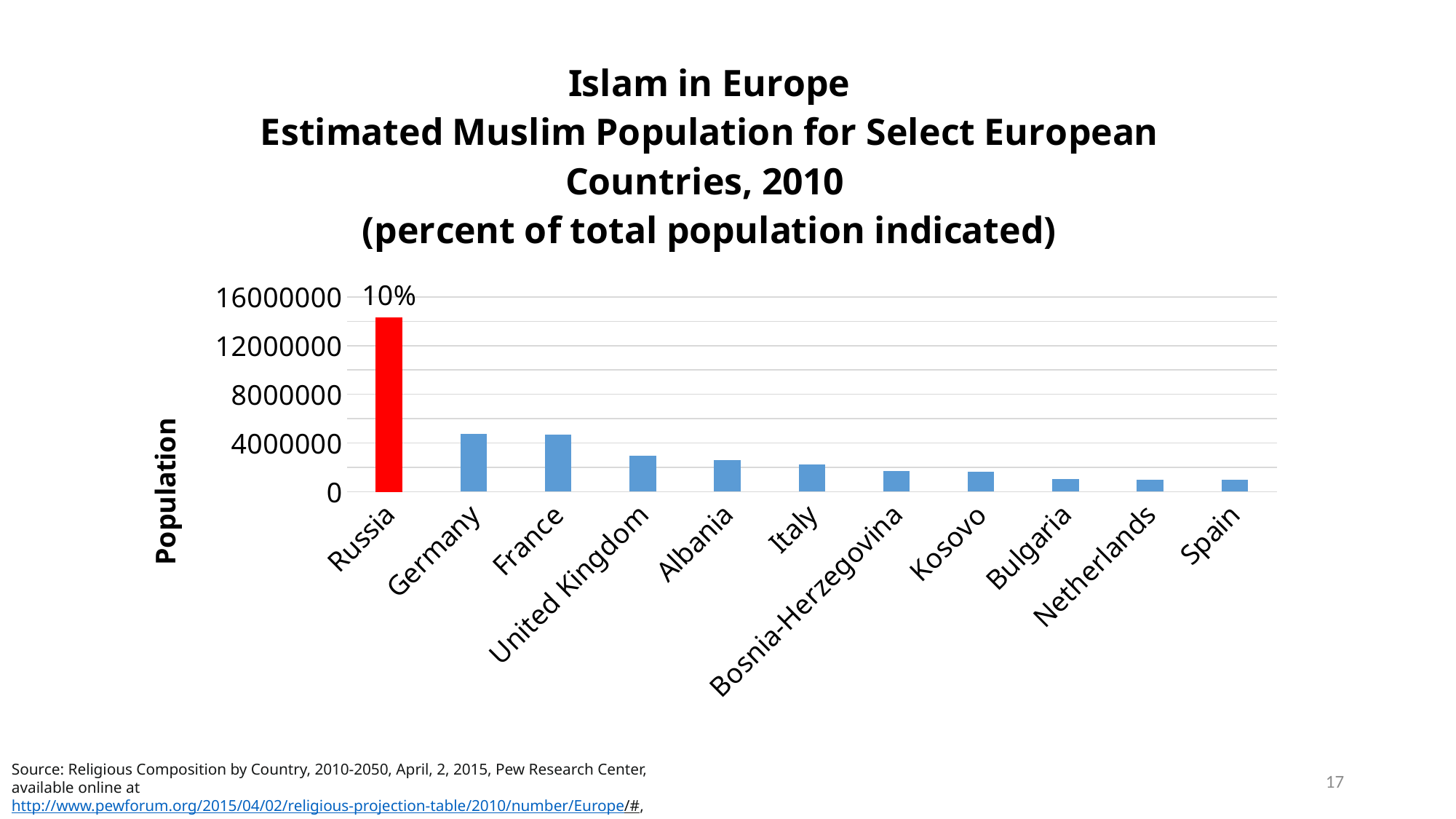
What colour is the bar for Russia? Red What kind of chart is shown on the slide? Bar chart Is the value for Germany greater or less than 4000000? greater Which has a larger value, Germany or United Kingdom? Germany Which country has the highest estimated Muslim population in the chart? Russia What percentage label is printed above the Russia bar? 10% Is the value for Russia greater or less than 12000000? greater Do the values generally rise or fall moving from left to right along the x axis? fall Which has a larger value, Russia or Germany? Russia How many countries are shown on the x axis of the chart? 11 Is the value for Italy greater or less than 4000000? less